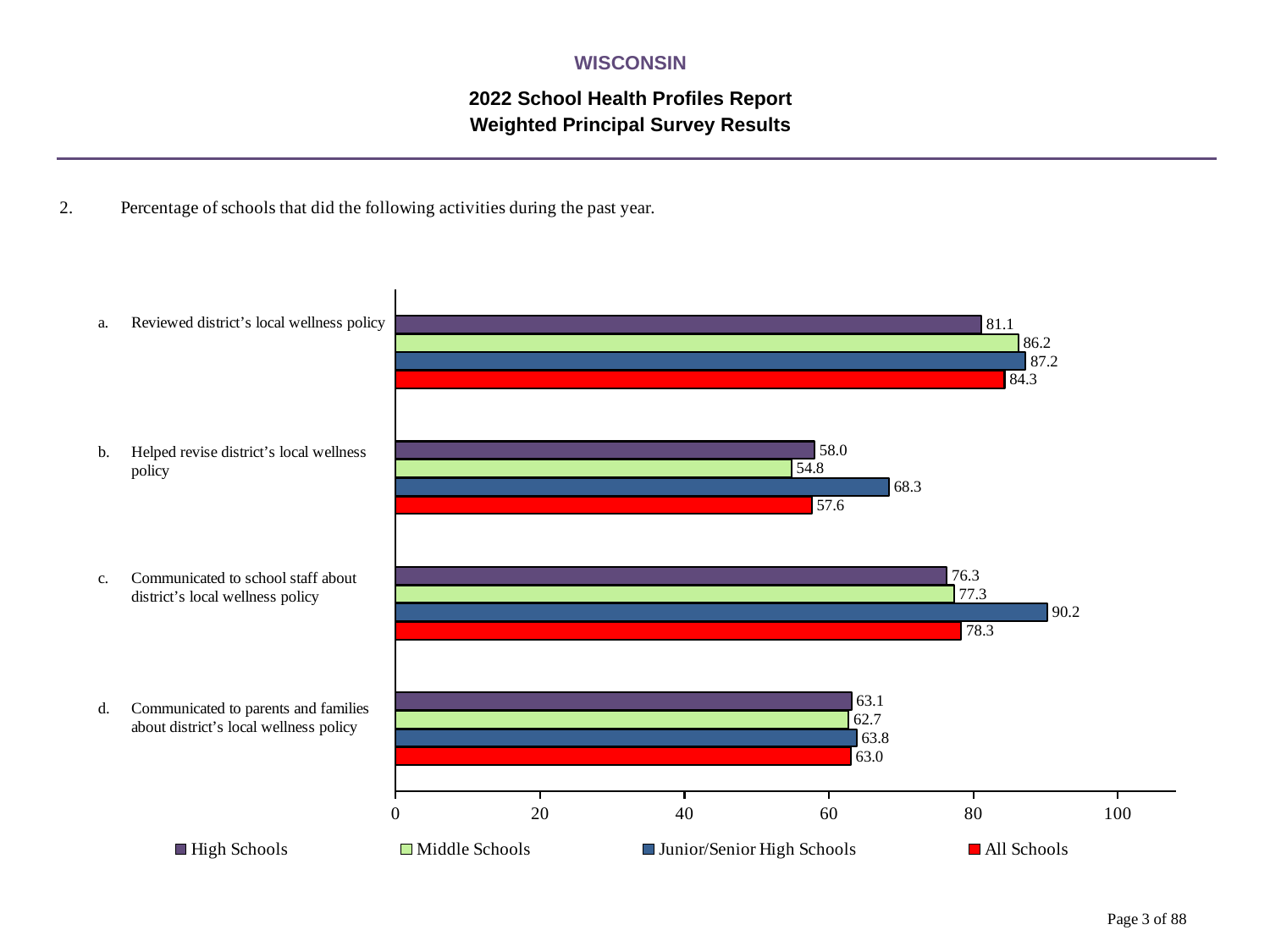
Which school type has the highest value for 'Helped revise district's local wellness policy'? Junior/Senior High Schools What kind of chart is shown on the slide? bar chart For 'Communicated to school staff about district's local wellness policy', which is larger: the High Schools value or the All Schools value? All Schools What is the All Schools value for 'Helped revise district's local wellness policy'? 57.6 Is the Middle Schools value for 'Reviewed district's local wellness policy' greater or less than 80? greater Which school type has the lowest value for 'Reviewed district's local wellness policy'? High Schools How many activities (categories) are shown in the chart? 4 What is the difference between the Junior/Senior High Schools and Middle Schools values for 'Helped revise district's local wellness policy'? 13.5 How many series does the legend list? 4 Which colour represents All Schools in the legend? red What is the value for Junior/Senior High Schools for 'Communicated to school staff about district's local wellness policy'? 90.2 What percentage of High Schools reviewed the district's local wellness policy? 81.1